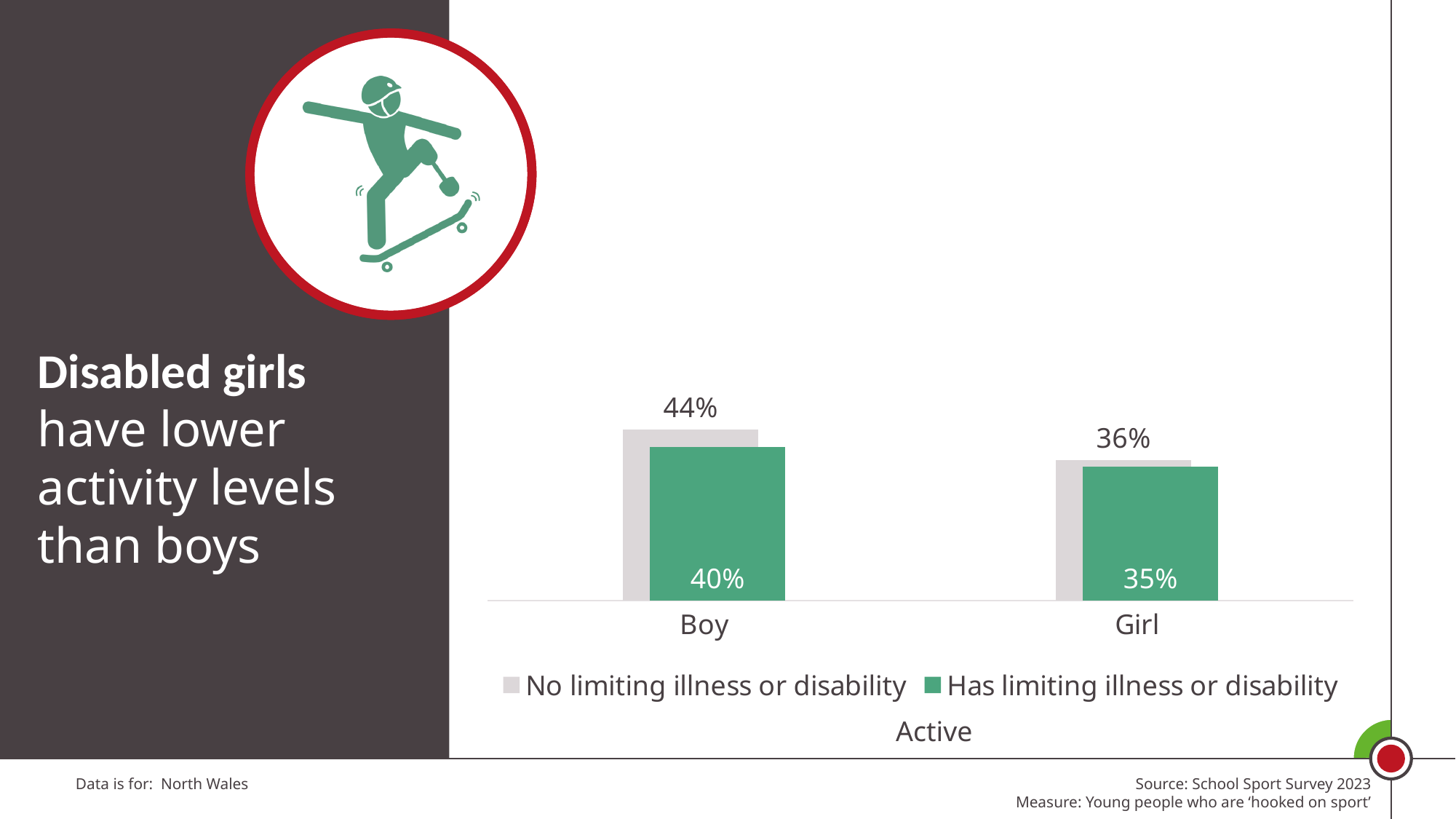
Which is larger: the 'Has limiting illness or disability' value for Boy or the 'No limiting illness or disability' value for Girl? Boy, Has limiting illness or disability What is the value for Boy in the 'No limiting illness or disability' series? 44% Which category has the highest value in the 'No limiting illness or disability' series? Boy What kind of chart is shown on the slide? Bar chart Which category has the lowest value in the 'Has limiting illness or disability' series? Girl What is the difference between the 'No limiting illness or disability' and 'Has limiting illness or disability' values for Boy? 4% How many categories are shown on the x axis of the chart? 2 How many series does the chart legend list? 2 What is the value for Girl in the 'Has limiting illness or disability' series? 35% What is the difference between the 'Has limiting illness or disability' values for Boy and Girl? 5% What is the value for Girl in the 'No limiting illness or disability' series? 36% What is the value for Boy in the 'Has limiting illness or disability' series? 40%